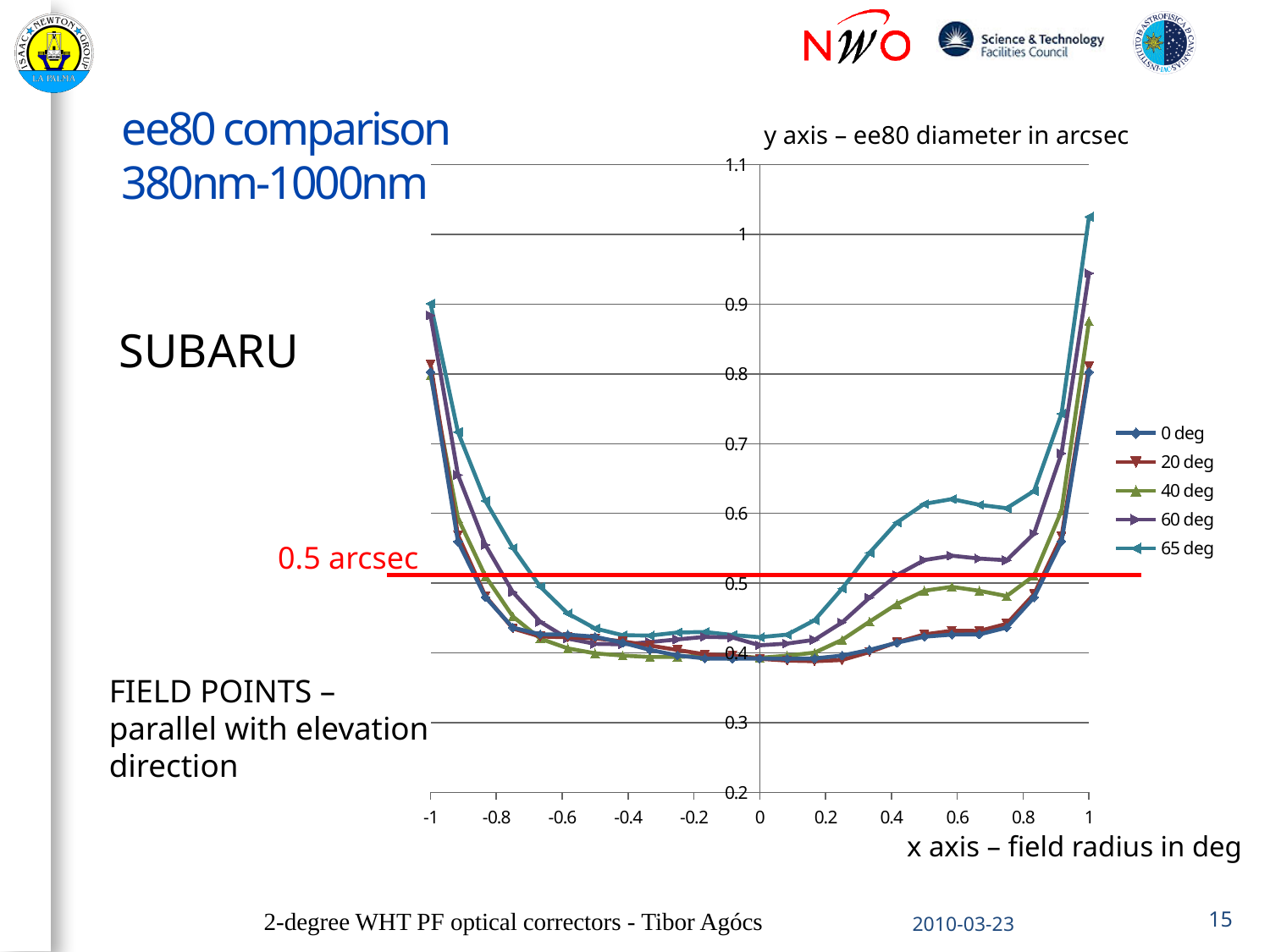
How many series does the legend list? 5 Is the value for 40 deg at x = 0.6 greater or less than 0.6? less Is the value for 0 deg at x = 0 greater or less than 0.5? less Is the value for 65 deg at x = 0.6 greater or less than 0.5? greater Which series reaches the highest value at x = 1? 65 deg Between x = 0.8 and x = 1, do the values of the series rise or fall? rise At x = 0.6, which series has the larger value, 60 deg or 40 deg? 60 deg Between x = -1 and x = -0.6, do the values of the series rise or fall? fall What value does the red horizontal line on the chart mark? 0.5 arcsec What are the series names listed in the legend? 0 deg, 20 deg, 40 deg, 60 deg, 65 deg What kind of chart is shown on the slide? line chart